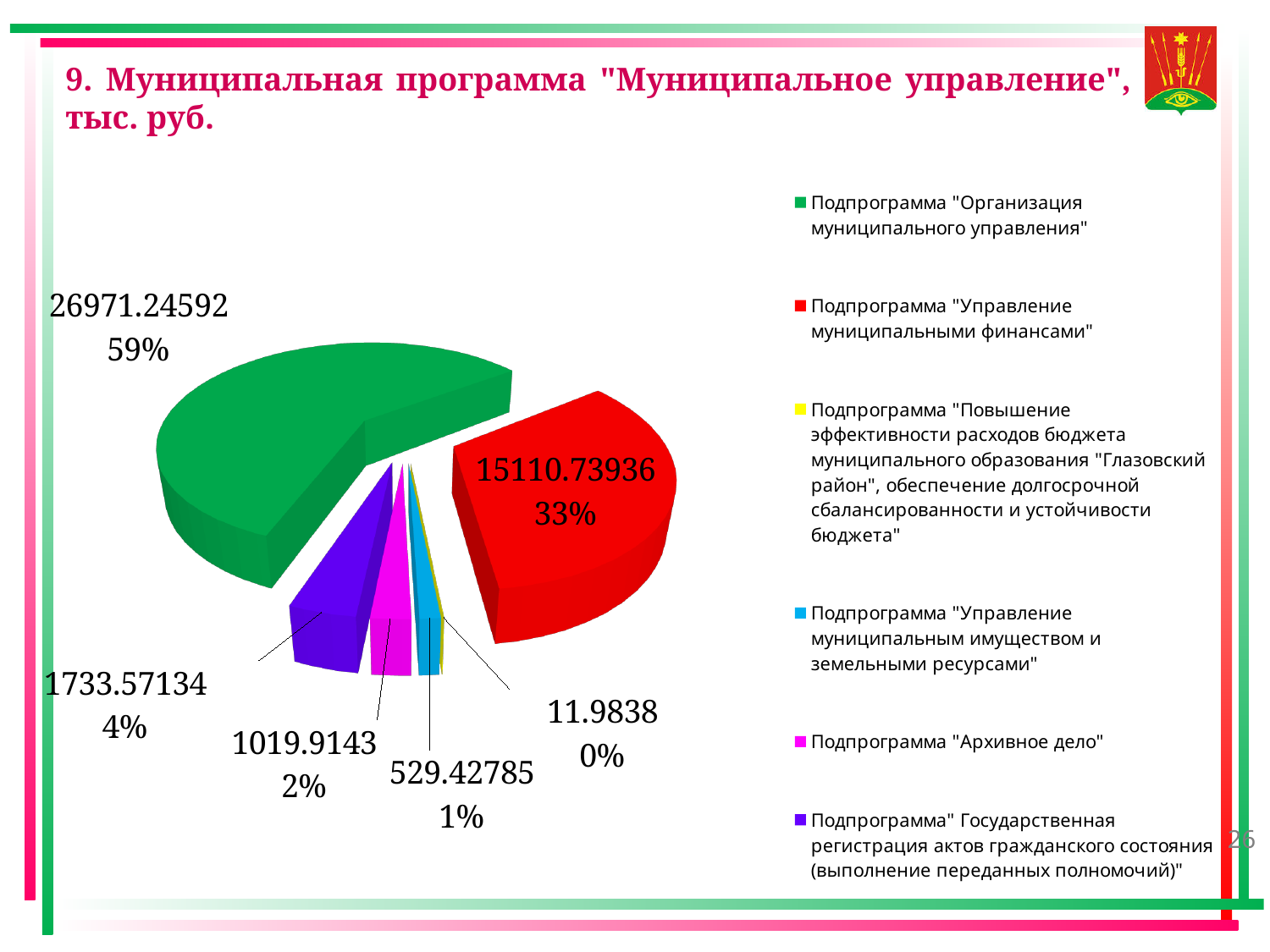
What is the value for Подпрограмма "Организация муниципального управления"? 26971.24592 What is the value for Подпрограмма "Управление муниципальными финансами"? 15110.73936 Which subprogram has the smallest slice of the pie? Подпрограмма "Повышение эффективности расходов бюджета муниципального образования "Глазовский район", обеспечение долгосрочной сбалансированности и устойчивости бюджета" What kind of chart is shown on the slide? Pie chart What share of the pie does Подпрограмма "Государственная регистрация актов гражданского состояния (выполнение переданных полномочий)" take? 4% What colour is the slice for Подпрограмма "Управление муниципальными финансами"? Red How many entries does the legend list? 6 What is the value for Подпрограмма "Архивное дело"? 1019.9143 What is the value for Подпрограмма "Управление муниципальным имуществом и земельными ресурсами"? 529.42785 Which is larger: the value for Подпрограмма "Архивное дело" or the value for Подпрограмма "Управление муниципальным имуществом и земельными ресурсами"? Подпрограмма "Архивное дело" What share of the pie does Подпрограмма "Организация муниципального управления" take? 59% How many slices does the pie chart have? 6